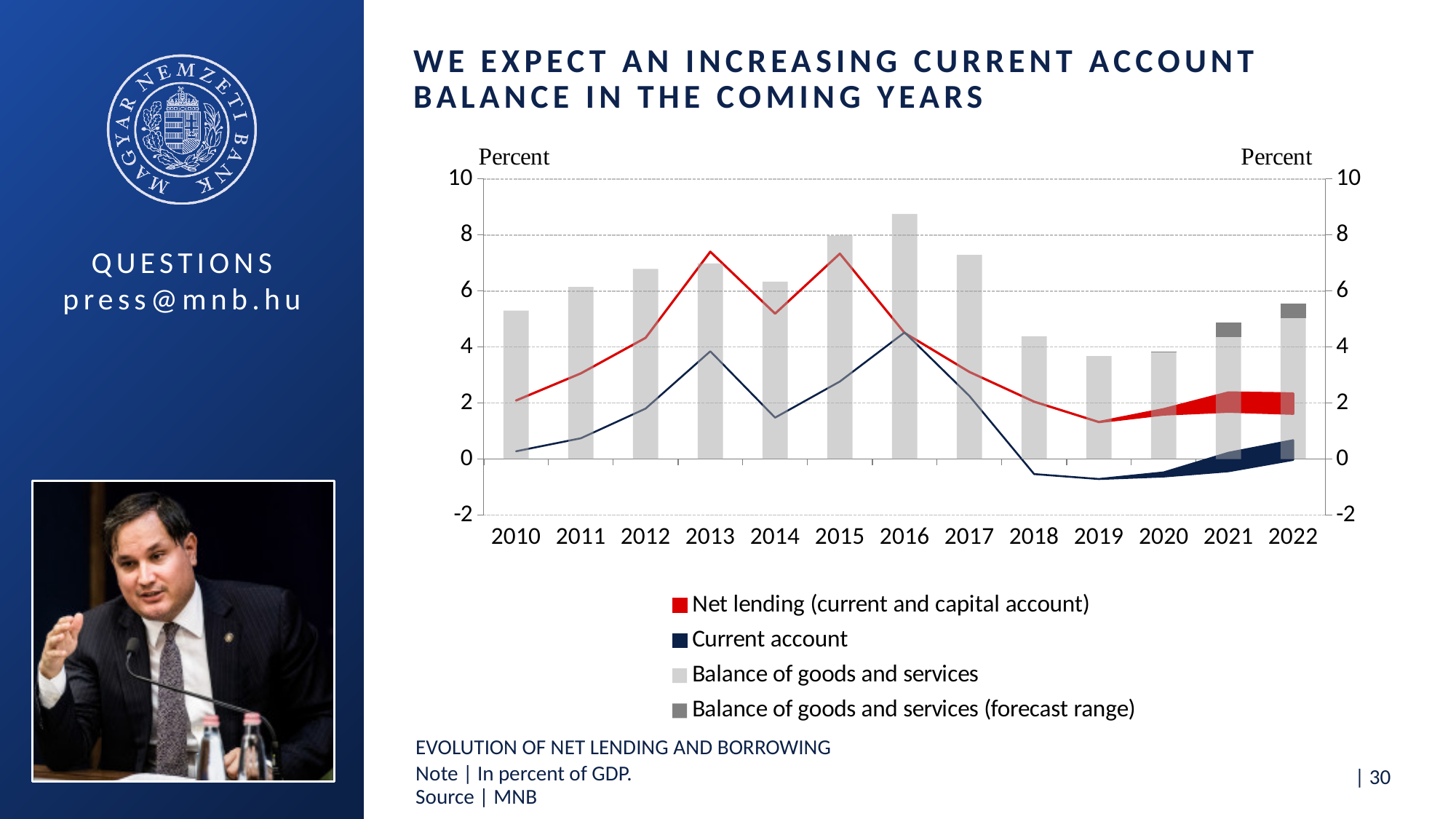
In which year is the Balance of goods and services bar the highest? 2016 In which year does the Current account line reach its highest value? 2016 Which colour represents Net lending (current and capital account) in the legend? Red How many years are shown on the x axis of the chart? 13 What kind of chart is shown on the slide? A combination bar and line chart Is the Balance of goods and services value for 2016 greater or less than 8? greater Which is larger, the Balance of goods and services bar for 2014 or for 2015? 2015 How many series does the chart's legend list? 4 Is the Current account value for 2018 greater or less than 0? less In which year does the Net lending (current and capital account) line reach its lowest value? 2019 Does the Current account line rise or fall between 2016 and 2019? fall Is the Net lending (current and capital account) value for 2013 greater or less than 6? greater